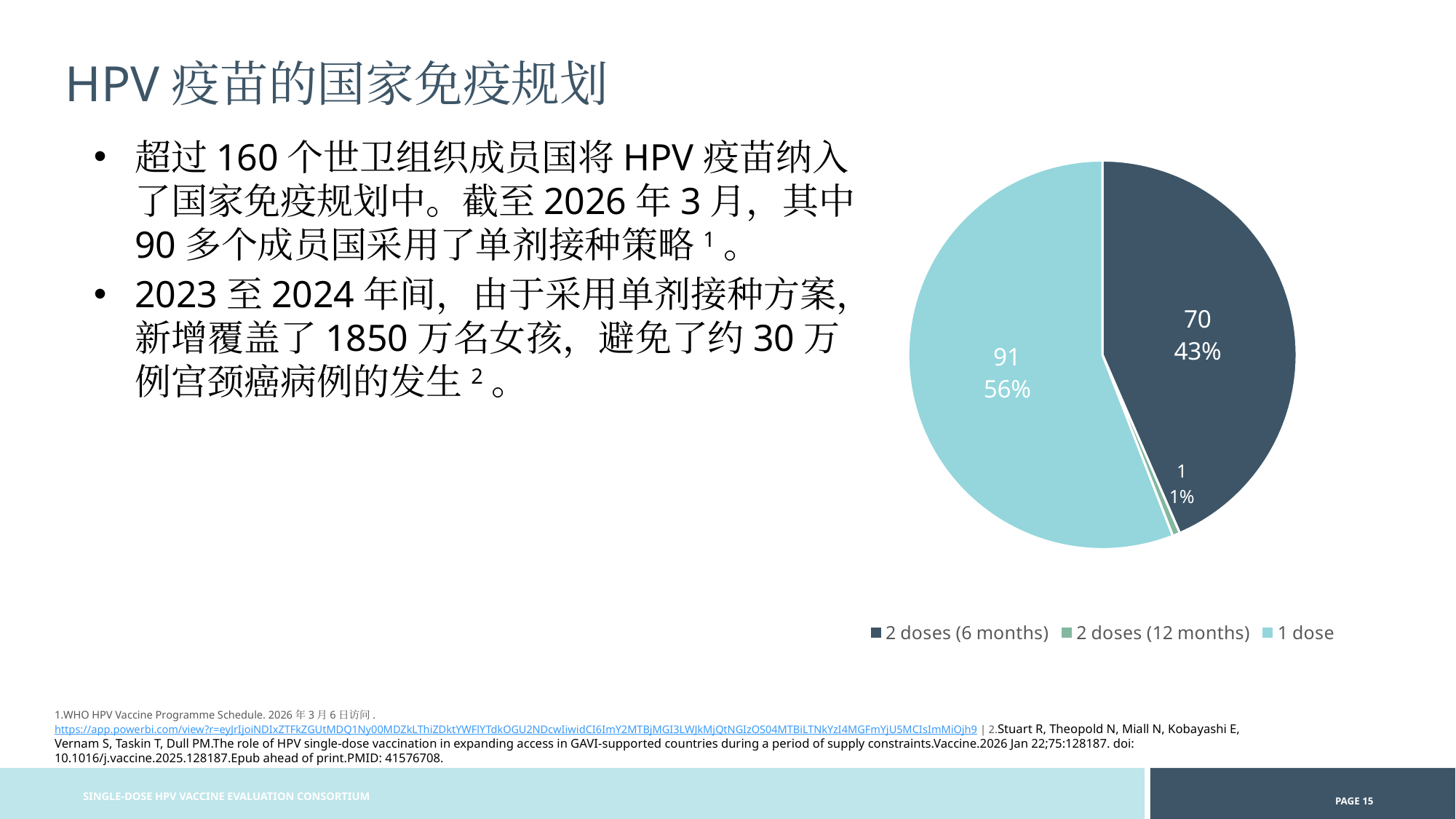
How many categories does the legend list? 3 What share of the pie does '2 doses (6 months)' represent? 43% Which category has the largest slice of the pie? 1 dose How many countries are shown for the '1 dose' slice? 91 What share of the pie does '1 dose' represent? 56% Which is larger, the '1 dose' slice or the '2 doses (6 months)' slice? 1 dose What is the difference between the '1 dose' count and the '2 doses (6 months)' count? 21 How many countries are shown for the '2 doses (12 months)' slice? 1 How many countries are shown for the '2 doses (6 months)' slice? 70 What is the total of the three values shown on the pie chart? 162 What kind of chart is shown on the slide? pie chart Which category has the smallest slice of the pie? 2 doses (12 months)